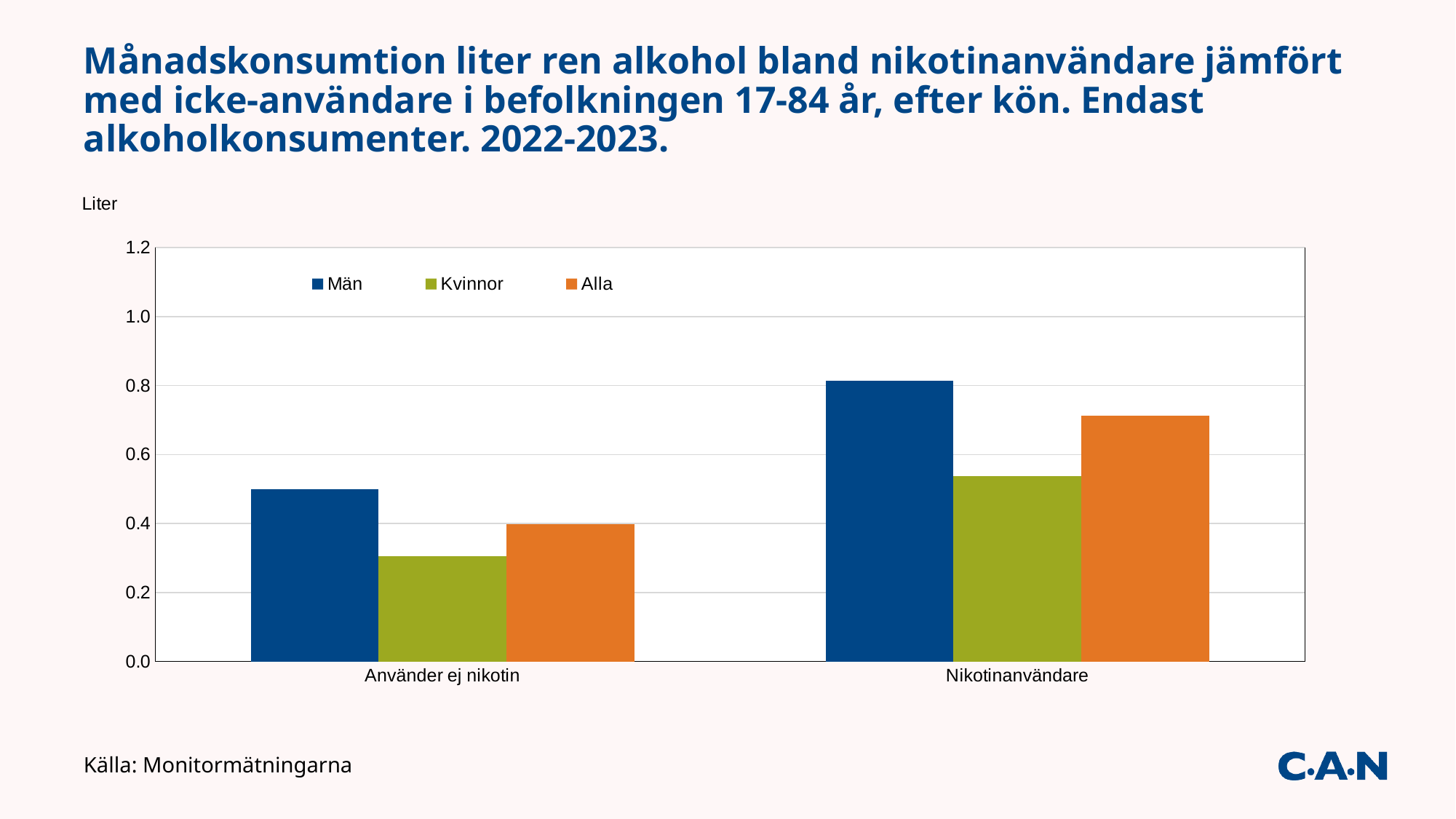
Which is larger, the value for Män or for Kvinnor among Använder ej nikotin? Män Which series has the lowest bar in the Använder ej nikotin category? Kvinnor Is the value for Alla among Nikotinanvändare greater or less than 0.6? greater Is the value for Män among Nikotinanvändare greater or less than 0.6? greater Is the value for Kvinnor among Använder ej nikotin greater or less than 0.4? less What unit is shown on the y axis of the chart? Liter Do the values for Alla rise or fall from Använder ej nikotin to Nikotinanvändare? rise How many categories are shown on the x axis? 2 Which series has the highest bar in the Nikotinanvändare category? Män How many series does the legend list? 3 What kind of chart is shown on the slide? bar chart